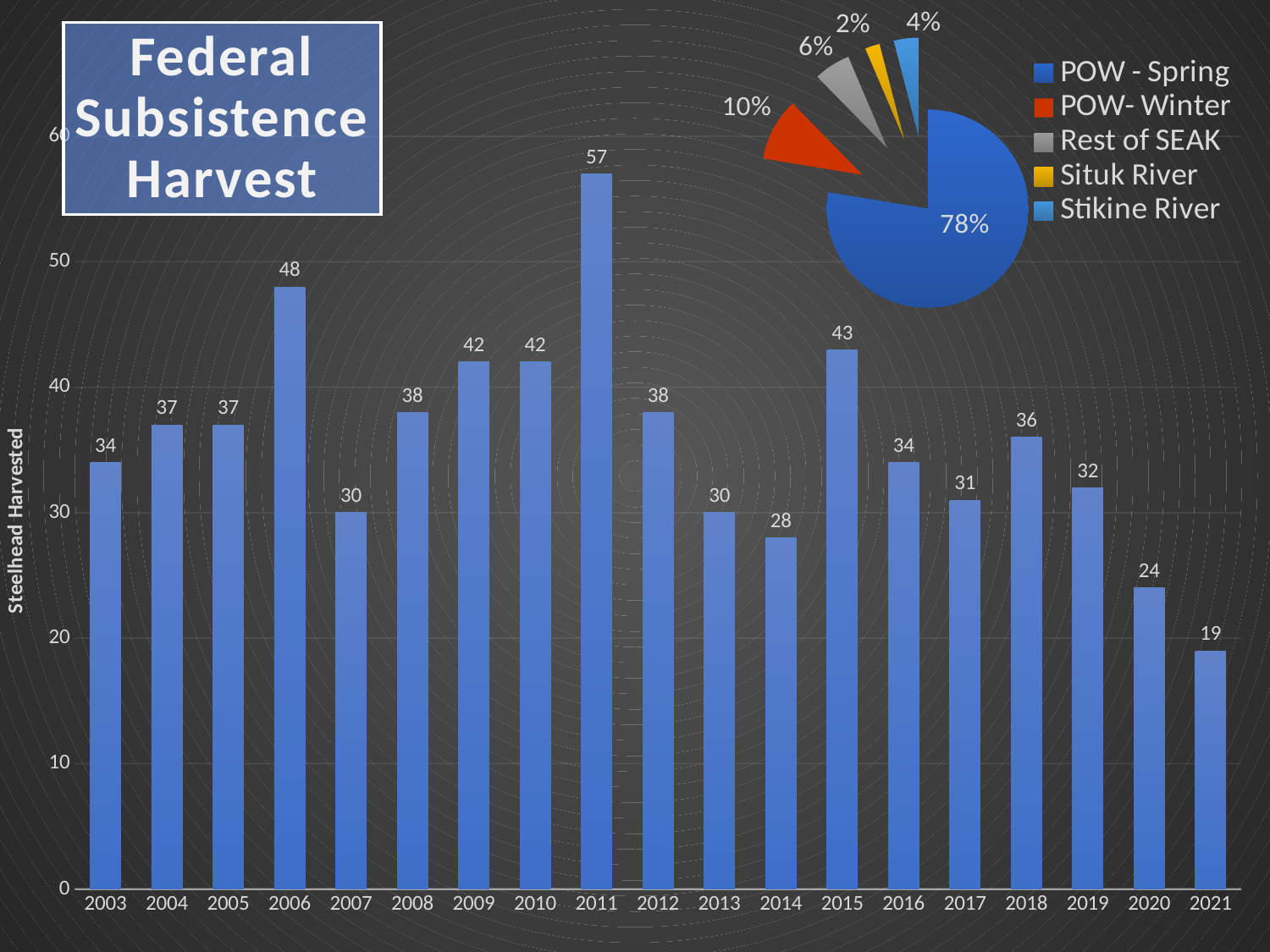
In the pie chart, what share does Rest of SEAK have? 6% How many entries does the pie chart legend list? 5 What is the label on the vertical axis of the bar chart? Steelhead Harvested In the bar chart, what is the difference between the 2006 and 2007 harvests? 18 In the bar chart, how many steelhead were harvested in 2011? 57 In the bar chart, which year had a larger harvest, 2015 or 2018? 2015 In the bar chart, which year has the lowest harvest? 2021 In the bar chart, how many years are shown on the x axis? 19 In the bar chart, do the values rise or fall from 2018 to 2021? Fall In the bar chart, which year has the highest harvest? 2011 What type of chart is the large chart showing harvest by year? Bar chart In the pie chart, what share does POW - Spring have? 78%